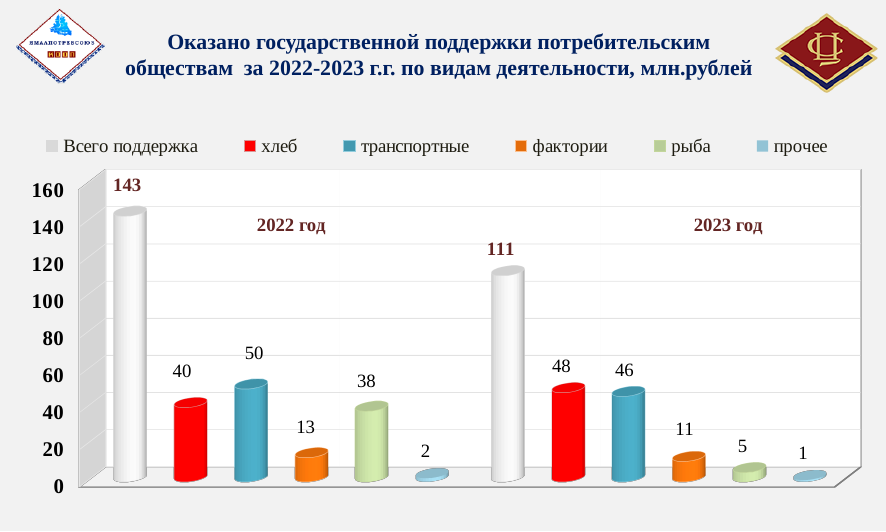
What is the value of 'фактории' for 2023 год? 11 Does the value of 'рыба' rise or fall from 2022 год to 2023 год? fall What kind of chart is shown on the slide? bar chart What is the difference between 'Всего поддержка' for 2022 год and 2023 год? 32 How many series does the legend list? 6 Which is larger: 'транспортные' in 2022 год or 'транспортные' in 2023 год? 2022 год What colour are the bars for 'хлеб'? red What is the value of 'хлеб' for 2023 год? 48 Which series has the lowest value in 2023 год? прочее What is the value of 'Всего поддержка' for 2022 год? 143 What is the value of 'рыба' for 2022 год? 38 Excluding 'Всего поддержка', which series has the highest value in 2022 год? транспортные